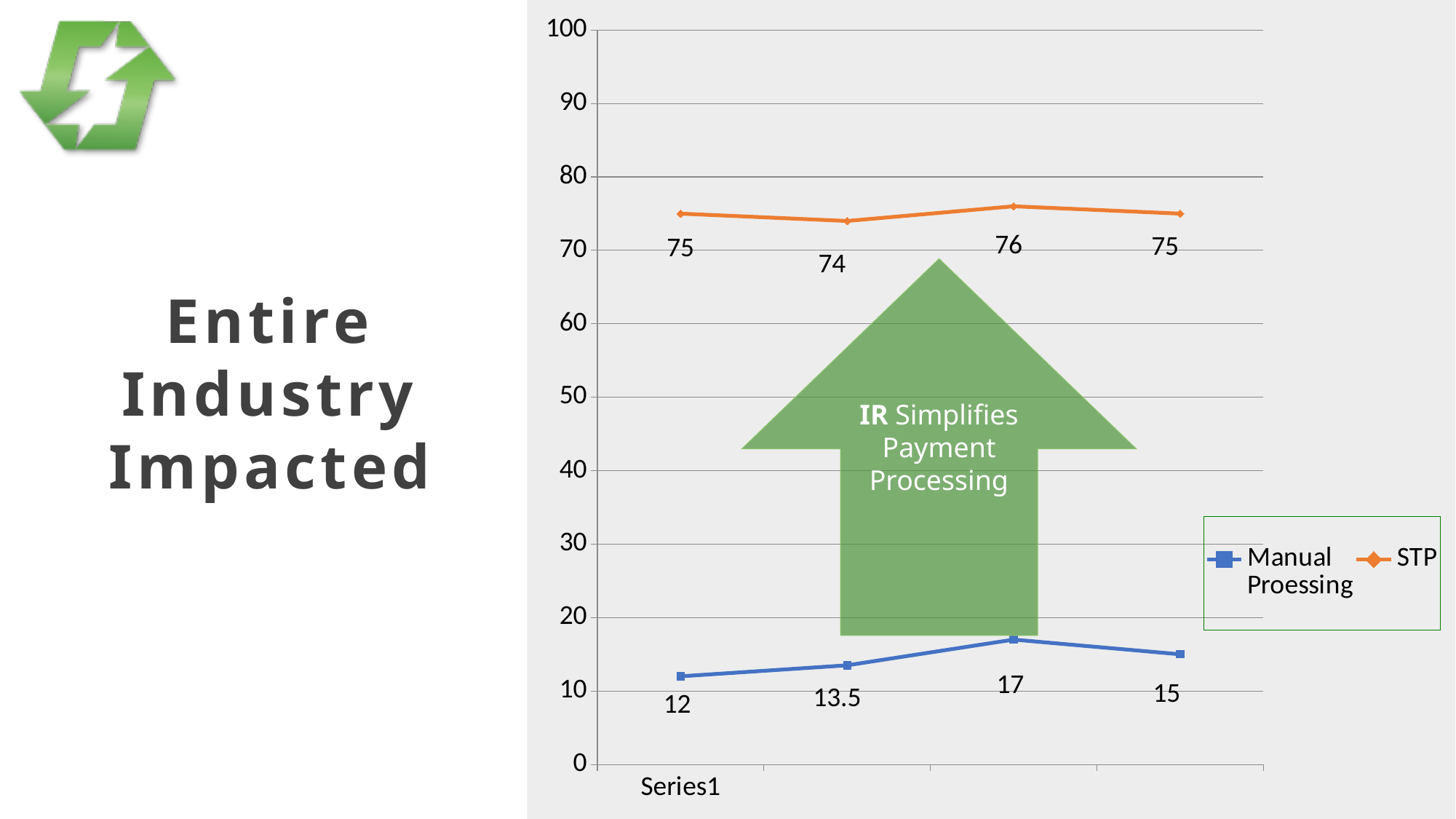
What text is written inside the green arrow on the chart? IR Simplifies Payment Processing Which series has the larger value at the first point (Series1), Manual Proessing or STP? STP What is the value of the Manual Proessing series at the first point (Series1)? 12 Is the value of the Manual Proessing series at the third point greater or less than 20? less What is the value of the STP series at the first point (Series1)? 75 What is the value of the Manual Proessing series at the second point? 13.5 How many series does the legend list? 2 What is the highest value shown on the STP line? 76 What is the difference between the STP value and the Manual Proessing value at the third point? 59 How many data points does the STP line have? 4 What is the lowest value shown on the Manual Proessing line? 12 What kind of chart is shown on the slide? line chart